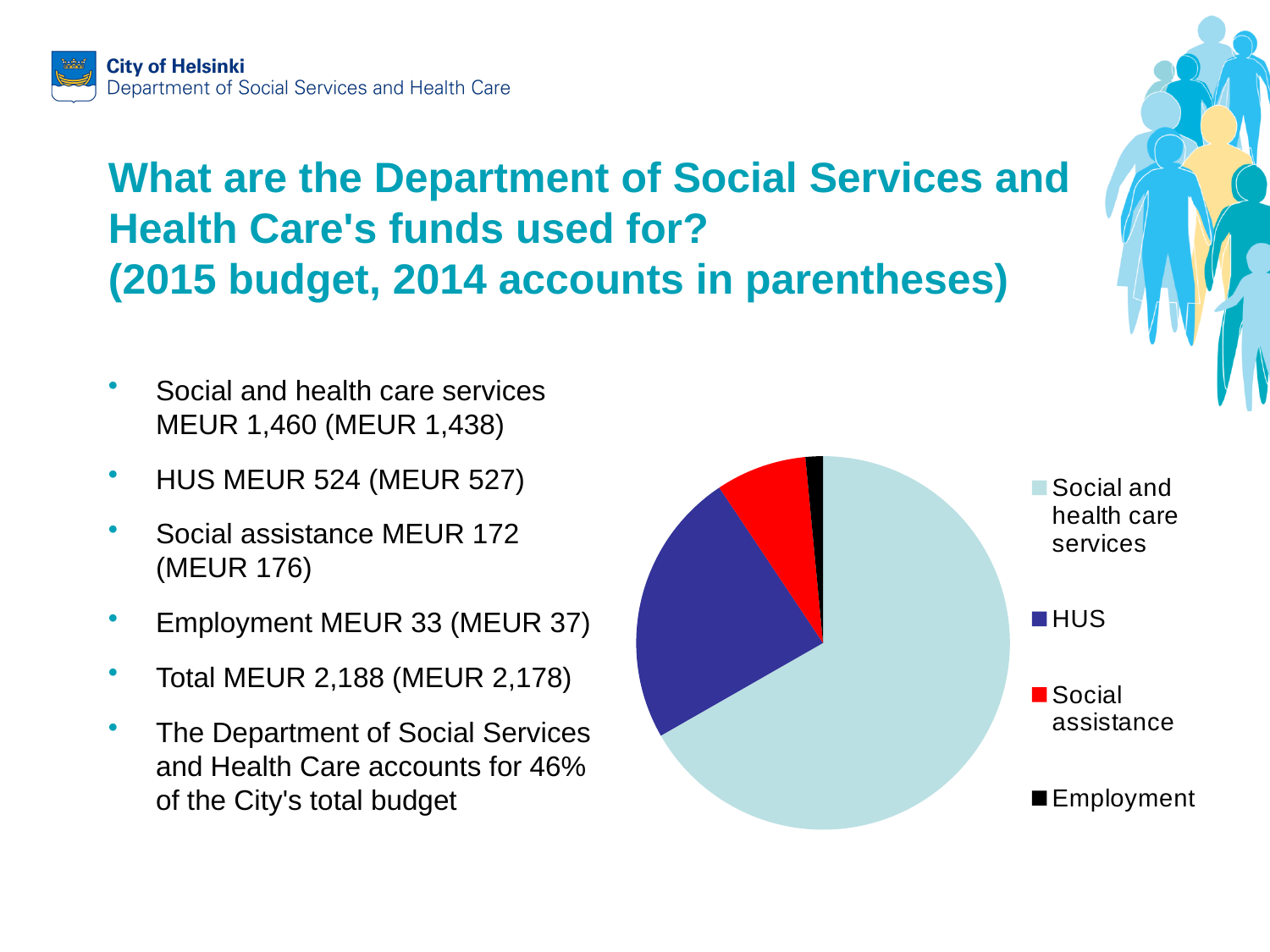
What colour is the HUS slice in the pie chart? dark blue According to the slide, what is the 2015 budget for HUS? MEUR 524 Using the 2015 budget figures on the slide, how much larger is Social and health care services than HUS? MEUR 936 How many slices does the pie chart have? 4 What colour is the Employment slice in the pie chart? black According to the slide, what is the 2015 budget for Employment? MEUR 33 Which slice is larger in the pie chart, HUS or Social assistance? HUS Which category has the smallest slice of the pie chart? Employment What kind of chart is shown on the slide? pie chart According to the slide, what is the 2015 budget for Social assistance? MEUR 172 Which slice is larger in the pie chart, Social assistance or Employment? Social assistance Which category has the largest slice of the pie chart? Social and health care services